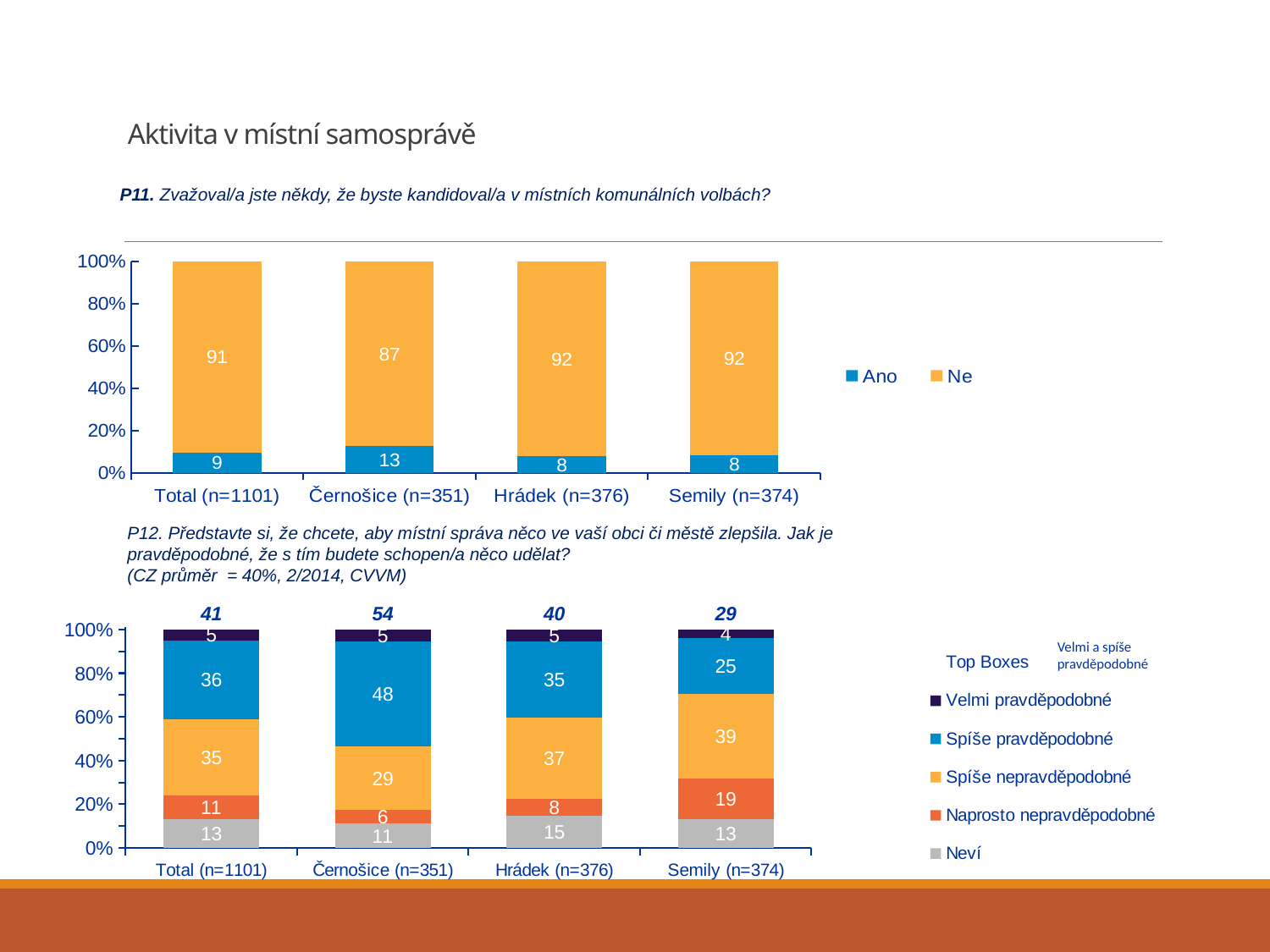
In the top chart (P11), how many series does the legend list? 2 In the bottom chart (P12), what is the difference between the Top Boxes values for Černošice (n=351) and Semily (n=374)? 25 In the top chart (P11), what is the difference between the "Ne" values for Černošice (n=351) and Total (n=1101)? 4 In the bottom chart (P12), how many series does the legend list? 6 In the top chart (P11), what is the value of "Ne" for Total (n=1101)? 91 In the bottom chart (P12), what is the value of "Spíše pravděpodobné" for Černošice (n=351)? 48 In the top chart (P11), which category has the highest "Ano" value? Černošice (n=351) In the top chart (P11), what is the value of "Ano" for Černošice (n=351)? 13 What type of chart is the bottom chart (P12)? Stacked bar chart In the bottom chart (P12), what is the value of "Naprosto nepravděpodobné" for Semily (n=374)? 19 In the bottom chart (P12), is the "Nevi" value larger for Hrádek (n=376) or for Černošice (n=351)? Hrádek (n=376) In the bottom chart (P12), which category has the lowest Top Boxes value shown above the bars? Semily (n=374)